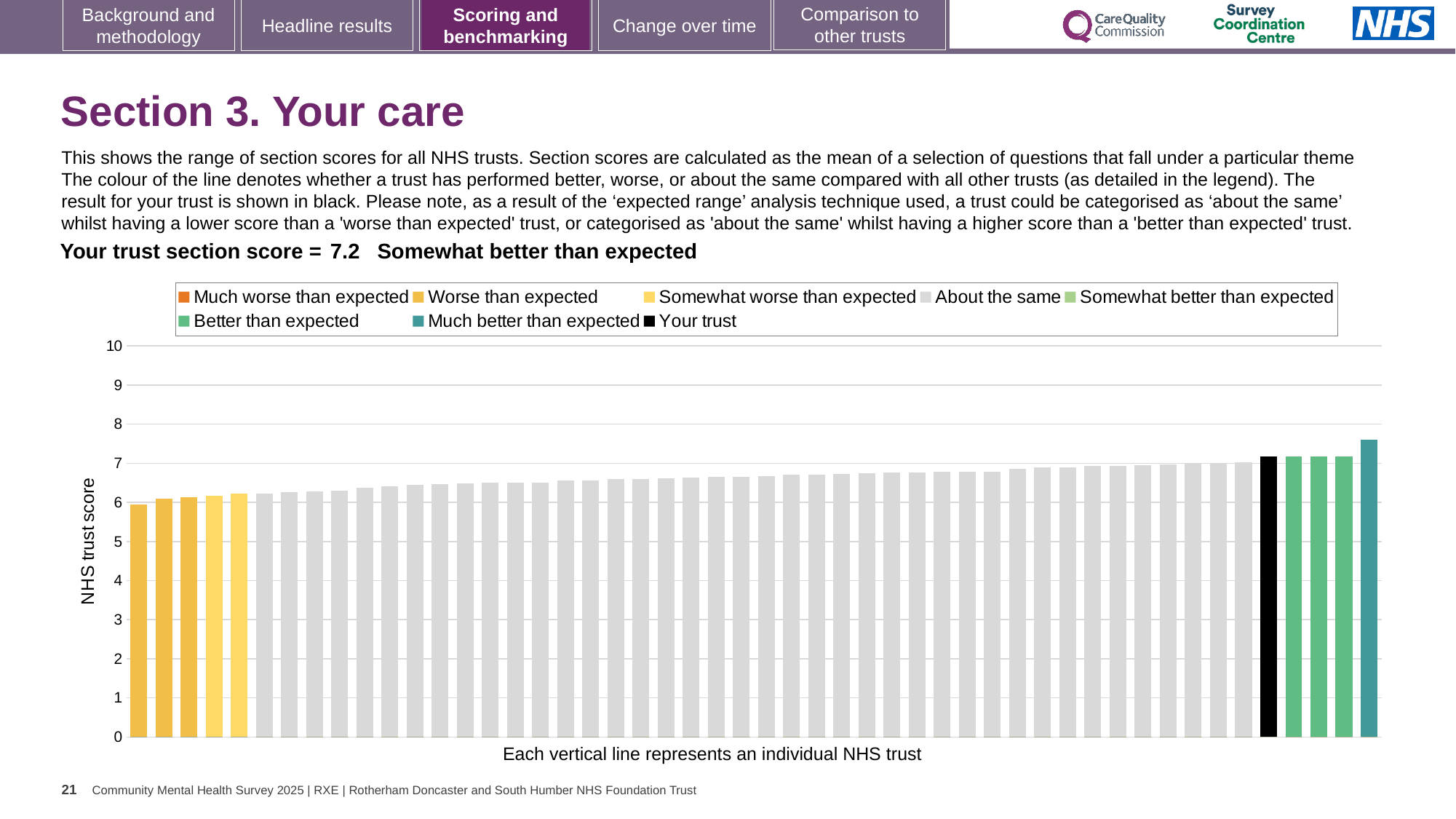
What is the label on the vertical axis of the chart? NHS trust score Which colour is used for the 'Your trust' bar in the chart? black Is the value of the highest bar greater or less than 8? less Is the value of the leftmost bar greater or less than 7? less How is your trust's section score categorised compared with other trusts? Somewhat better than expected How many bars are coloured as 'Much better than expected' (teal)? 1 Is the value of the black 'Your trust' bar greater or less than 7? greater How many entries does the chart legend list? 8 What kind of chart is shown on the slide? bar chart What is the section score for your trust shown on the slide? 7.2 Do the bar values rise or fall from left to right along the x axis? rise